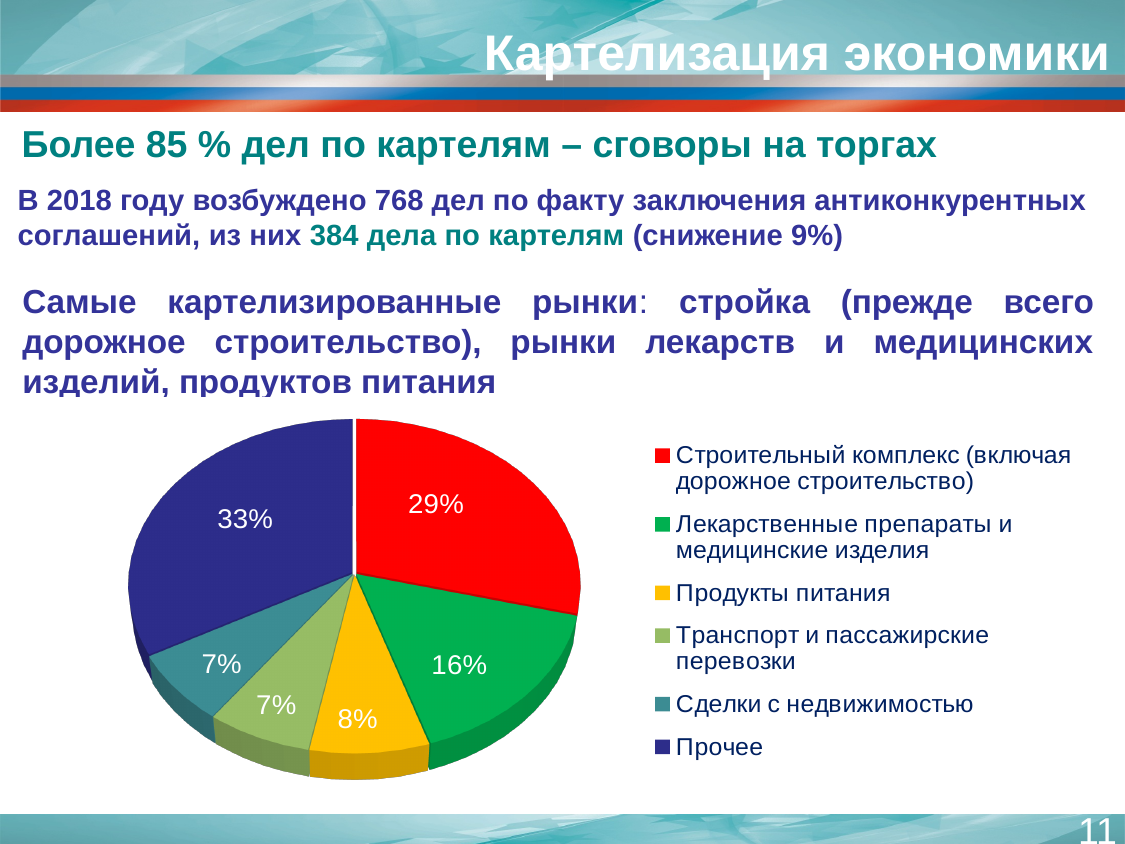
What is the value for "Продукты питания"? 8% Which is larger: the share for "Лекарственные препараты и медицинские изделия" or for "Продукты питания"? Лекарственные препараты и медицинские изделия What colour is the slice for "Продукты питания"? yellow What is the difference between the shares of "Прочее" and "Строительный комплекс (включая дорожное строительство)"? 4% What is the value for "Прочее"? 33% How many slices does the pie chart have? 6 What is the combined share of "Транспорт и пассажирские перевозки" and "Сделки с недвижимостью"? 14% What is the value for "Сделки с недвижимостью"? 7% What kind of chart is shown on the slide? pie chart What is the value for "Лекарственные препараты и медицинские изделия"? 16% Which category has the largest slice of the pie? Прочее What share of the pie does "Строительный комплекс (включая дорожное строительство)" have? 29%